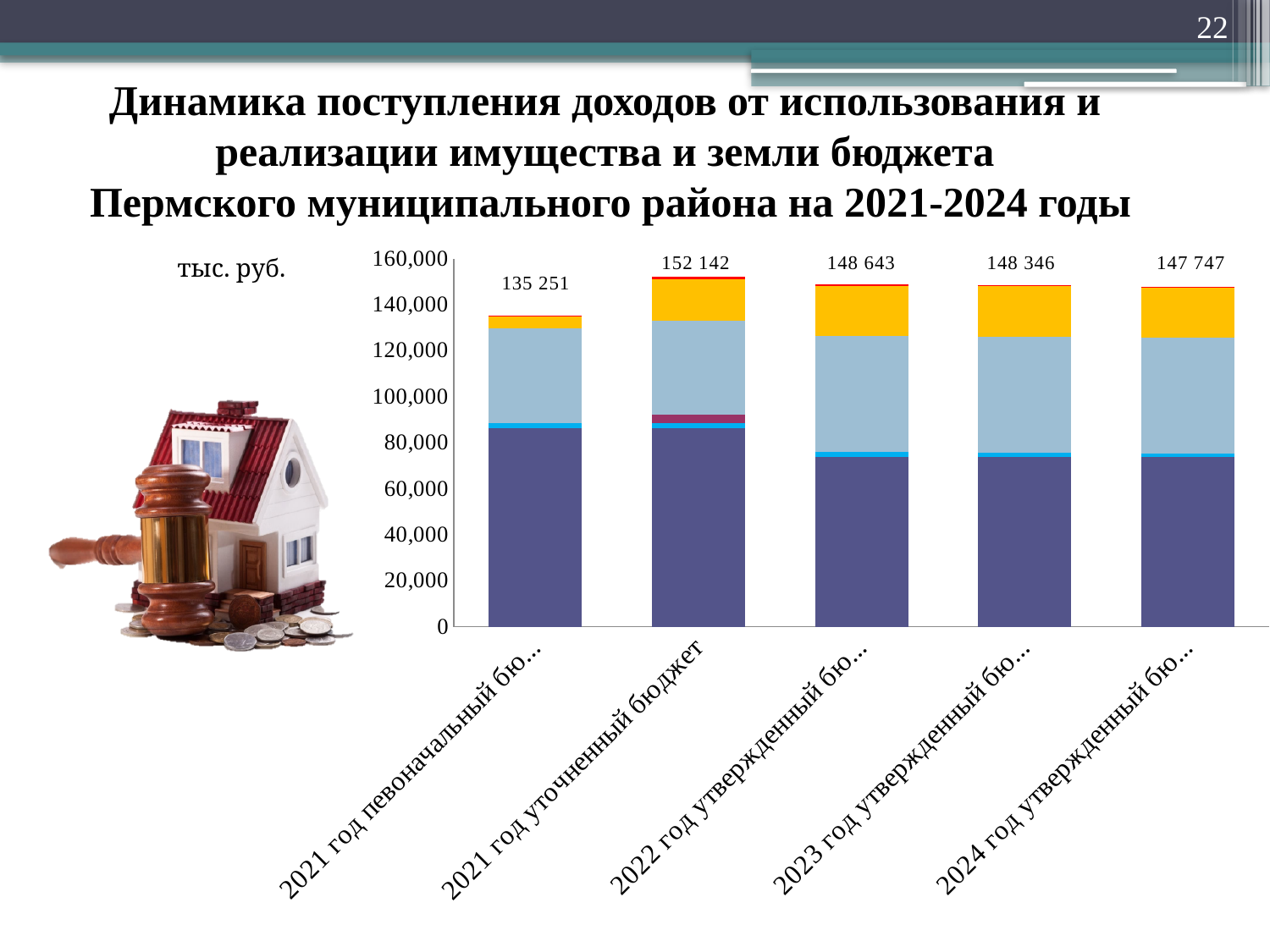
What is the difference between the labelled totals for 2023 год утвержденный бю... and 2024 год утвержденный бю...? 599 Do the labelled totals rise or fall from the 2022 bar to the 2024 bar? Fall What is the total value labelled on the first bar (2021 год певоначальный бю...)? 135 251 Which bar has the lowest labelled total? 2021 год певоначальный бю... What is the difference between the labelled totals for 2021 год уточненный бюджет and 2021 год певоначальный бю...? 16 891 What is the total value labelled on the bar for 2024 год утвержденный бю...? 147 747 Which bar has the highest labelled total? 2021 год уточненный бюджет How many bars are shown in the chart? 5 What kind of chart is shown on the slide? Stacked bar chart Is the bottom dark blue segment of the 2022 год утвержденный бю... bar greater or less than 80,000? less Which is larger: the labelled total for 2021 год уточненный бюджет or for 2022 год утвержденный бю...? 2021 год уточненный бюджет What is the total value labelled on the bar for 2021 год уточненный бюджет? 152 142